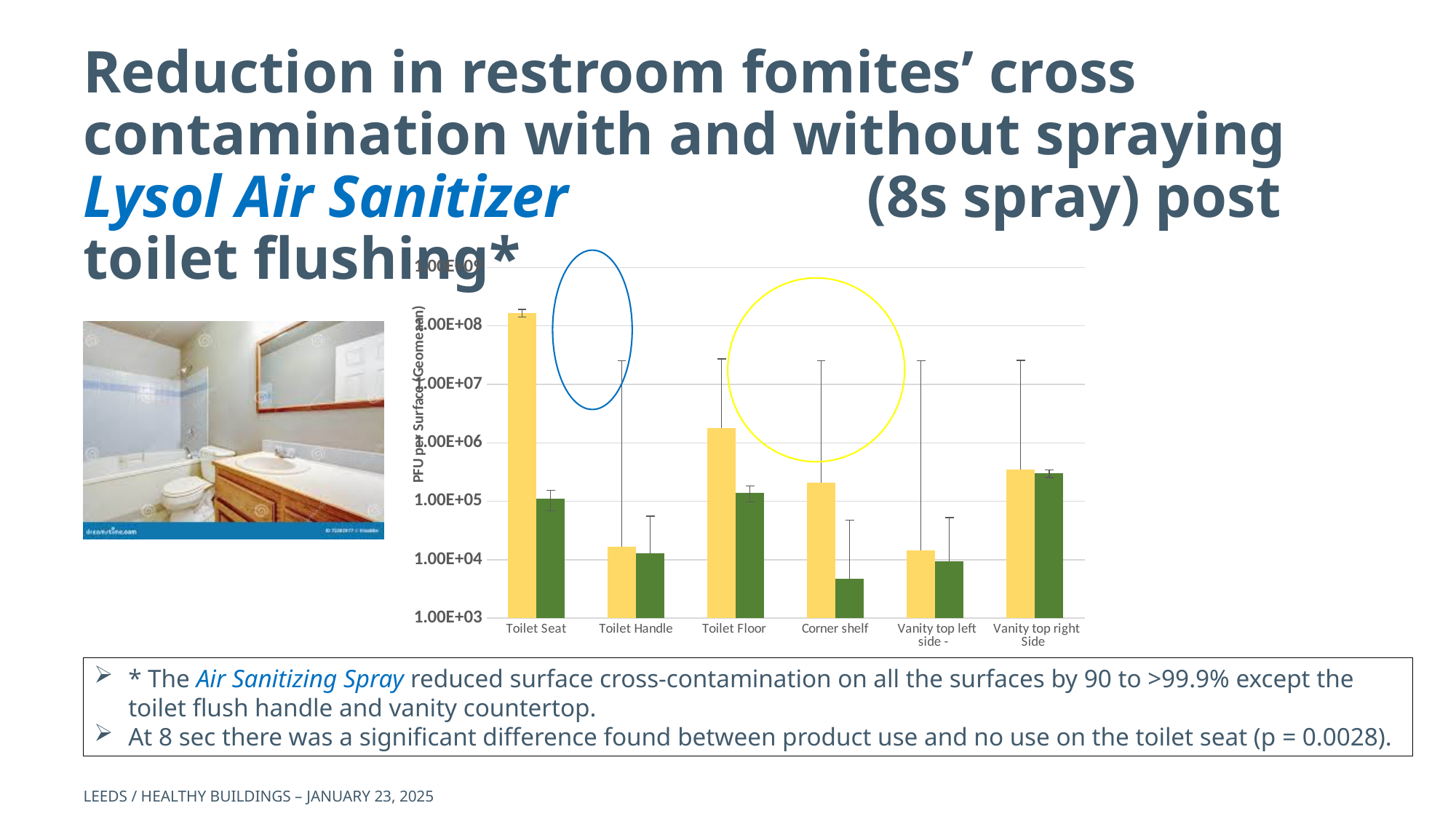
Is the yellow bar for Toilet Floor greater or less than 1.00E+06? greater Is the yellow bar for Toilet Seat greater or less than 1.00E+08? greater Which category has the lowest green bar in the chart? Corner shelf For Toilet Seat, which bar is larger, the yellow bar or the green bar? yellow For Corner shelf, which bar is larger, the yellow bar or the green bar? yellow What is the label of the y axis of the chart? PFU per Surface (Geomean) Is the green bar for Corner shelf greater or less than 1.00E+04? less Which category has the highest yellow bar in the chart? Toilet Seat What kind of chart is shown on the slide? bar chart How many surface categories are shown on the x axis of the chart? 6 Which category has the highest green bar in the chart? Vanity top right Side